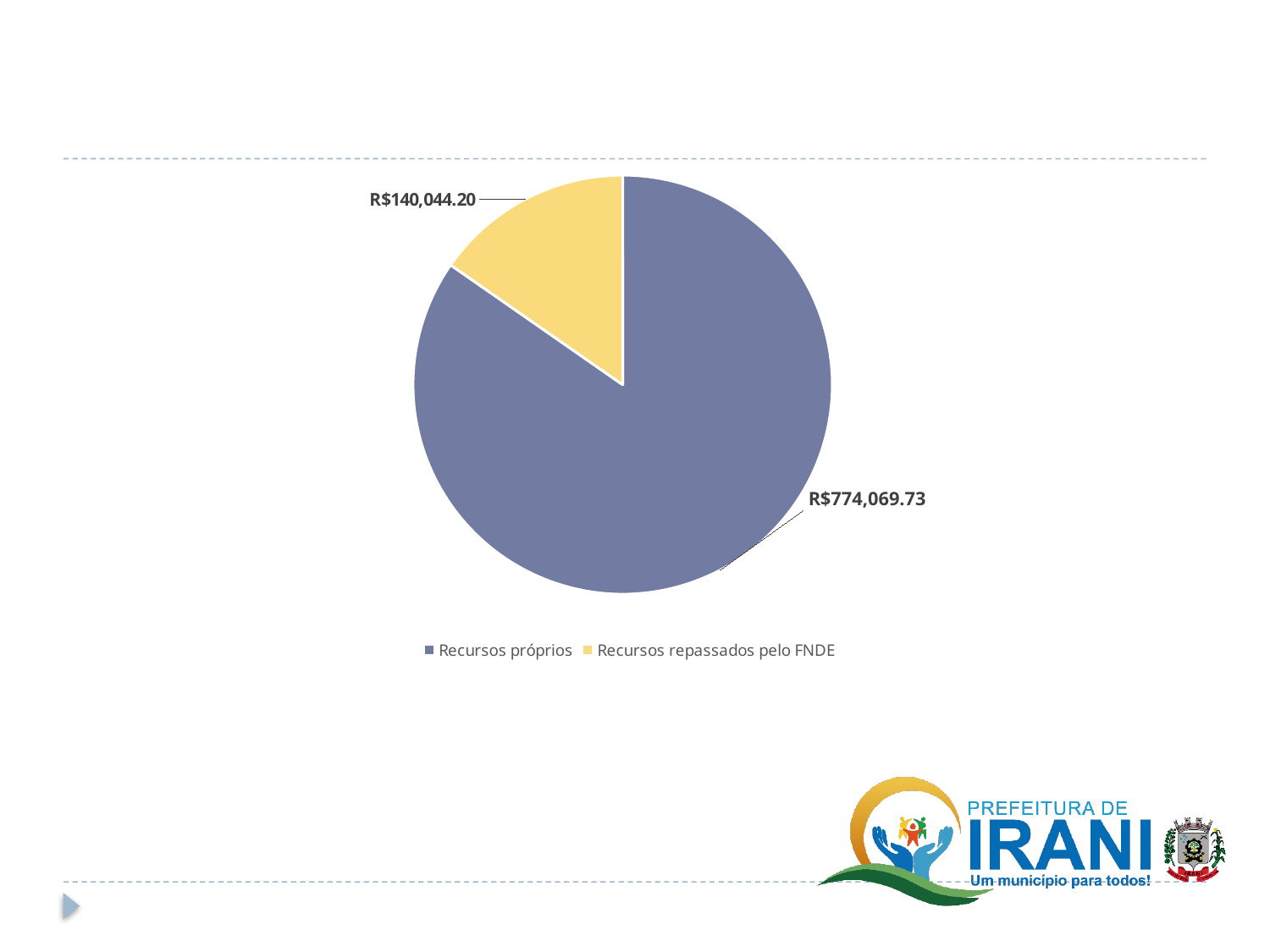
What colour is the slice for Recursos repassados pelo FNDE? yellow Approximately what share of the pie does Recursos repassados pelo FNDE represent, to one decimal place? 15.3% Which category has the smallest slice of the pie? Recursos repassados pelo FNDE Which is larger, Recursos próprios or Recursos repassados pelo FNDE? Recursos próprios How many entries does the legend list? 2 What is the total of the two slices in the pie chart? R$914,113.93 What is the value for Recursos repassados pelo FNDE? R$140,044.20 How many slices does the pie chart have? 2 What kind of chart is shown on the slide? pie chart What is the difference between Recursos próprios and Recursos repassados pelo FNDE? R$634,025.53 Which category has the largest slice of the pie? Recursos próprios What is the value for Recursos próprios? R$774,069.73